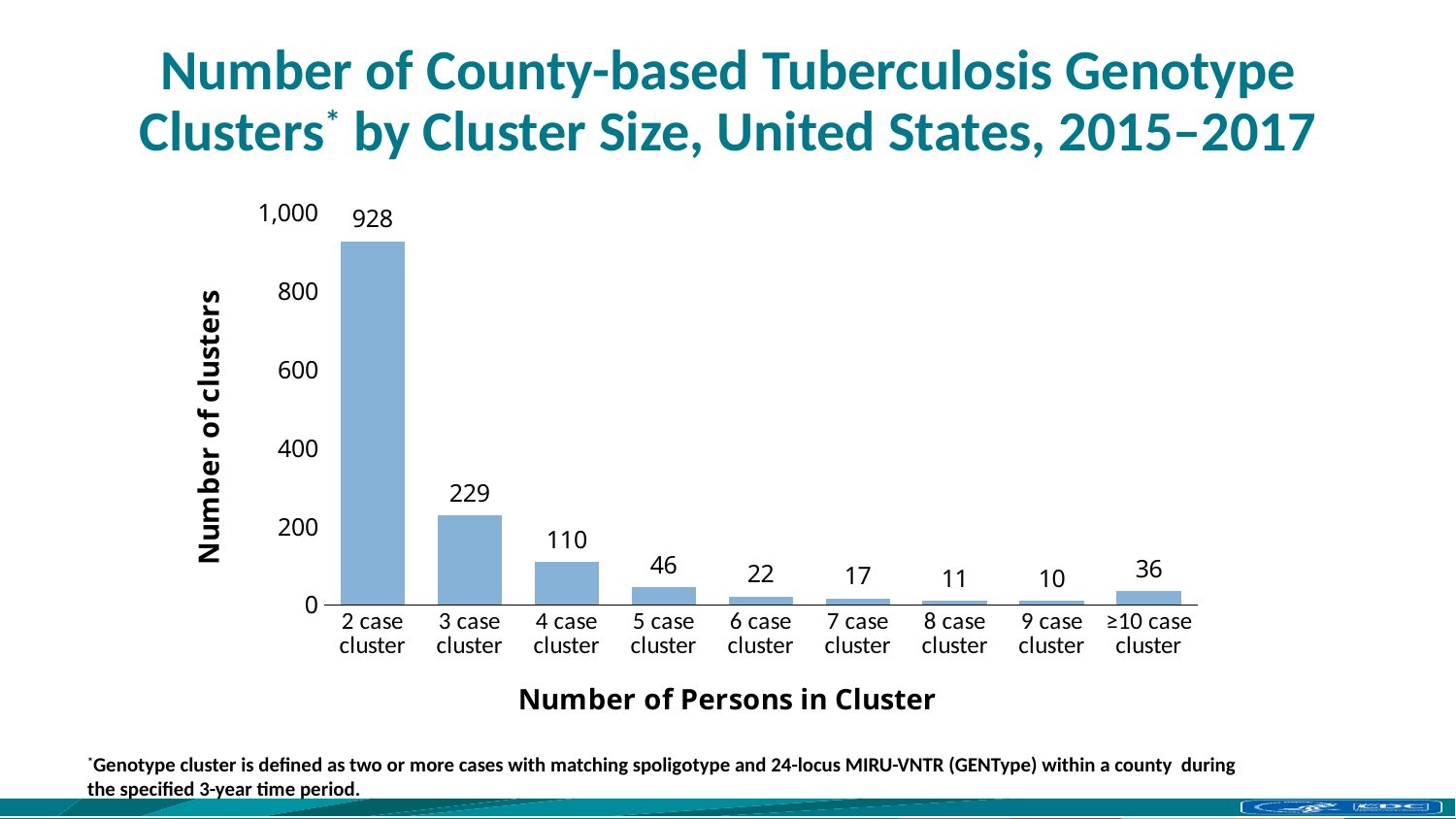
What is the label of the y axis? Number of clusters How many clusters are there for the 2 case cluster category? 928 Which cluster size has the highest number of clusters? 2 case cluster What is the difference in the number of clusters between the 4 case cluster and 5 case cluster categories? 64 What is the number of clusters for the 5 case cluster category? 46 Which has more clusters, the 8 case cluster or the ≥10 case cluster category? ≥10 case cluster What kind of chart is shown on the slide? Bar chart Is the number of clusters for the 3 case cluster category greater or less than 200? greater Which cluster size has the lowest number of clusters? 9 case cluster How many cluster size categories are shown on the x axis? 9 What is the difference in the number of clusters between the 2 case cluster and 3 case cluster categories? 699 What is the number of clusters for the ≥10 case cluster category? 36